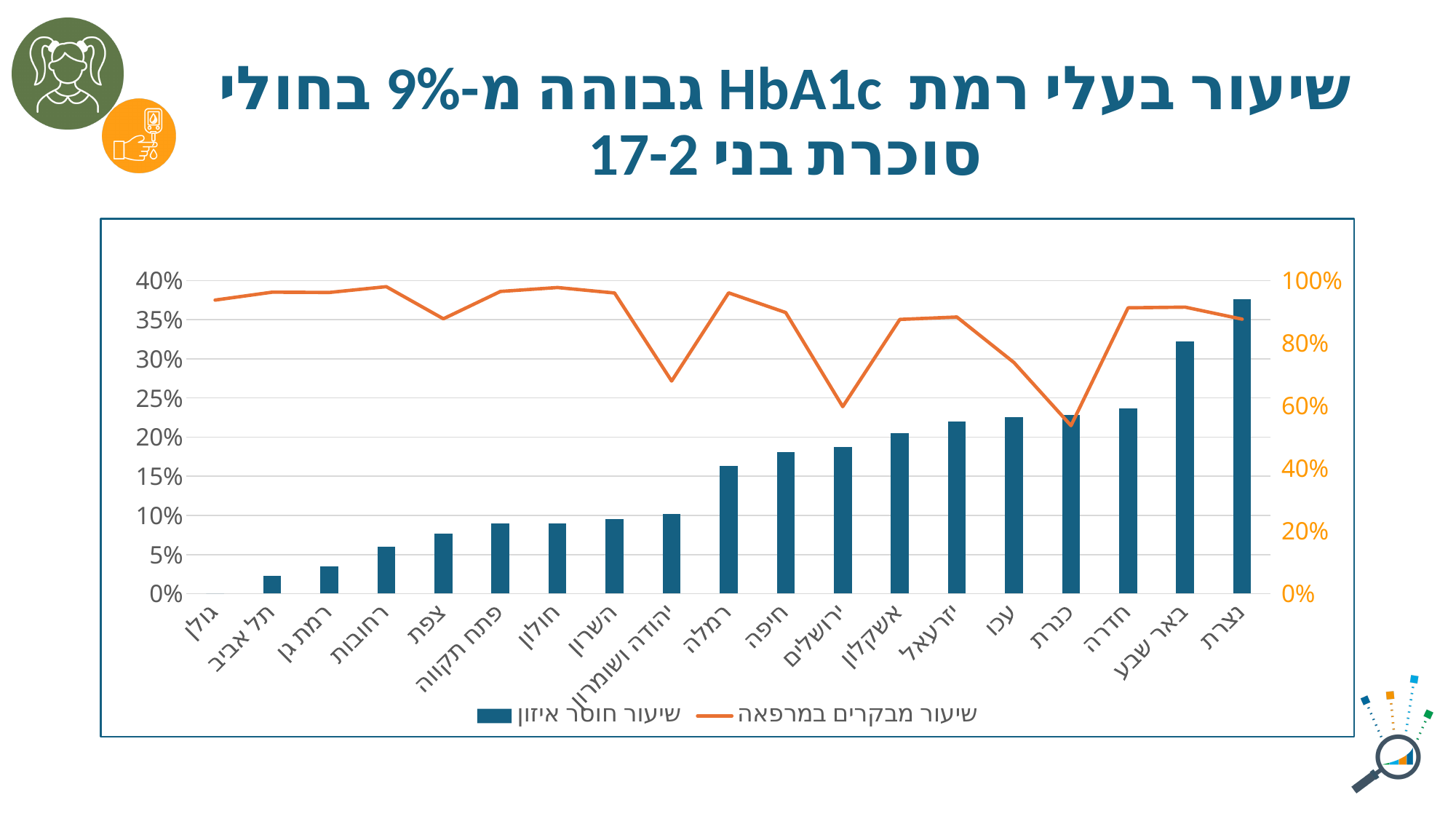
Which category has the tallest bar for שיעור חוסר איזון? נצרת Do the bar values rise or fall from left to right along the x axis? rise Is the bar value for באר שבע greater or less than 30%? greater Is the שיעור מבקרים במרפאה line value for יהודה ושומרון greater or less than 80%? less How many series does the legend list? 2 Which category has the lowest point on the שיעור מבקרים במרפאה line? כנרת What kind of chart is shown on the slide? A combination bar and line chart Is the שיעור מבקרים במרפאה line value for כנרת greater or less than 60%? less Which has the larger bar value, חיפה or רמלה? חיפה How many categories are shown on the x axis? 19